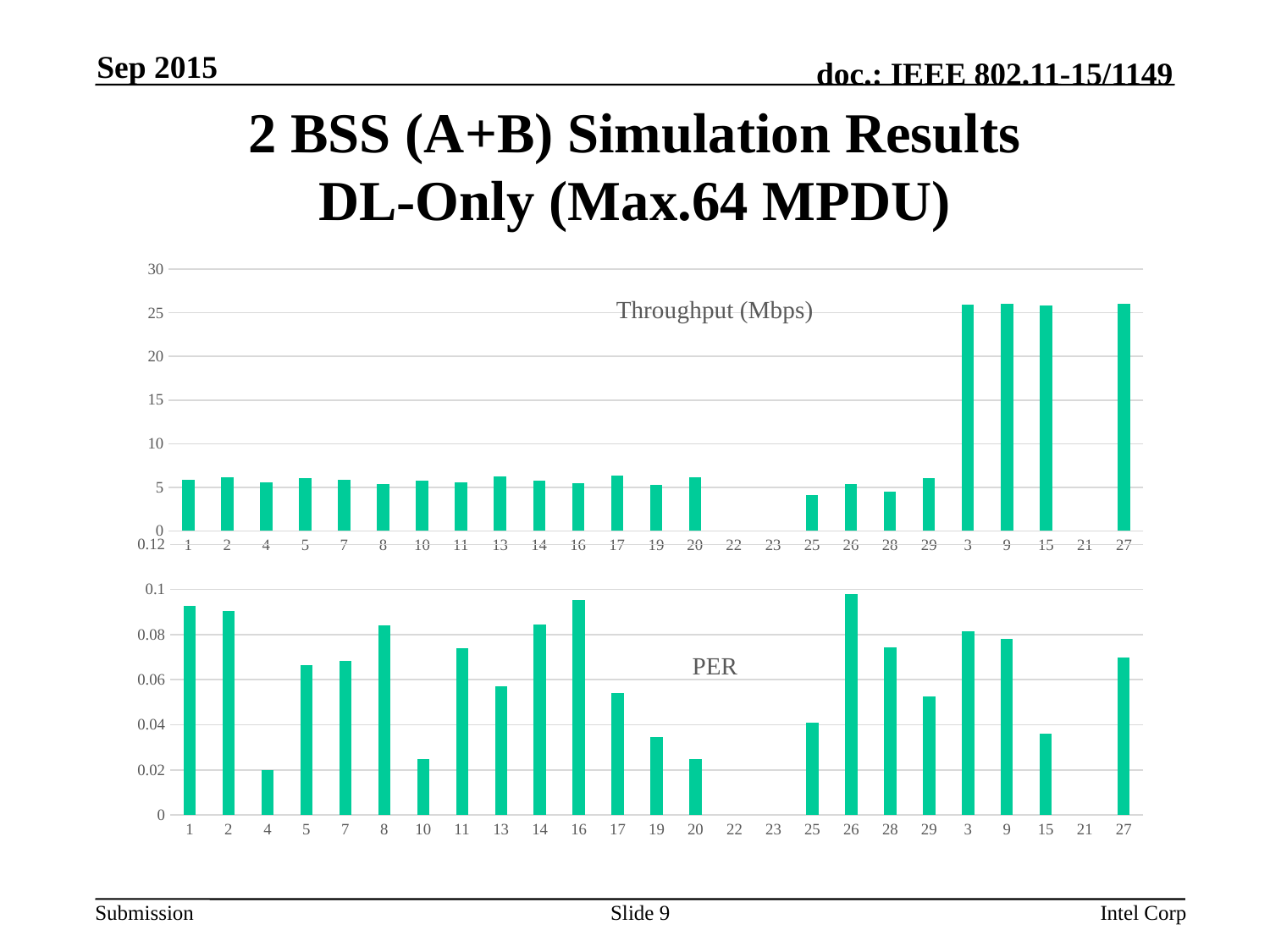
In the PER chart, which has the larger value, category 1 or category 4? 1 In the Throughput (Mbps) chart, is the value for category 3 greater or less than 25? greater In the Throughput (Mbps) chart, which has the larger value, category 3 or category 25? 3 How many categories are shown on the x axis of the PER chart? 25 What kind of chart is the Throughput (Mbps) chart? bar chart In the Throughput (Mbps) chart, is the value for category 1 greater or less than 5? greater In the PER chart, is the value for category 26 greater or less than 0.08? greater What kind of chart is the PER chart? bar chart What is the title shown inside the top chart? Throughput (Mbps)